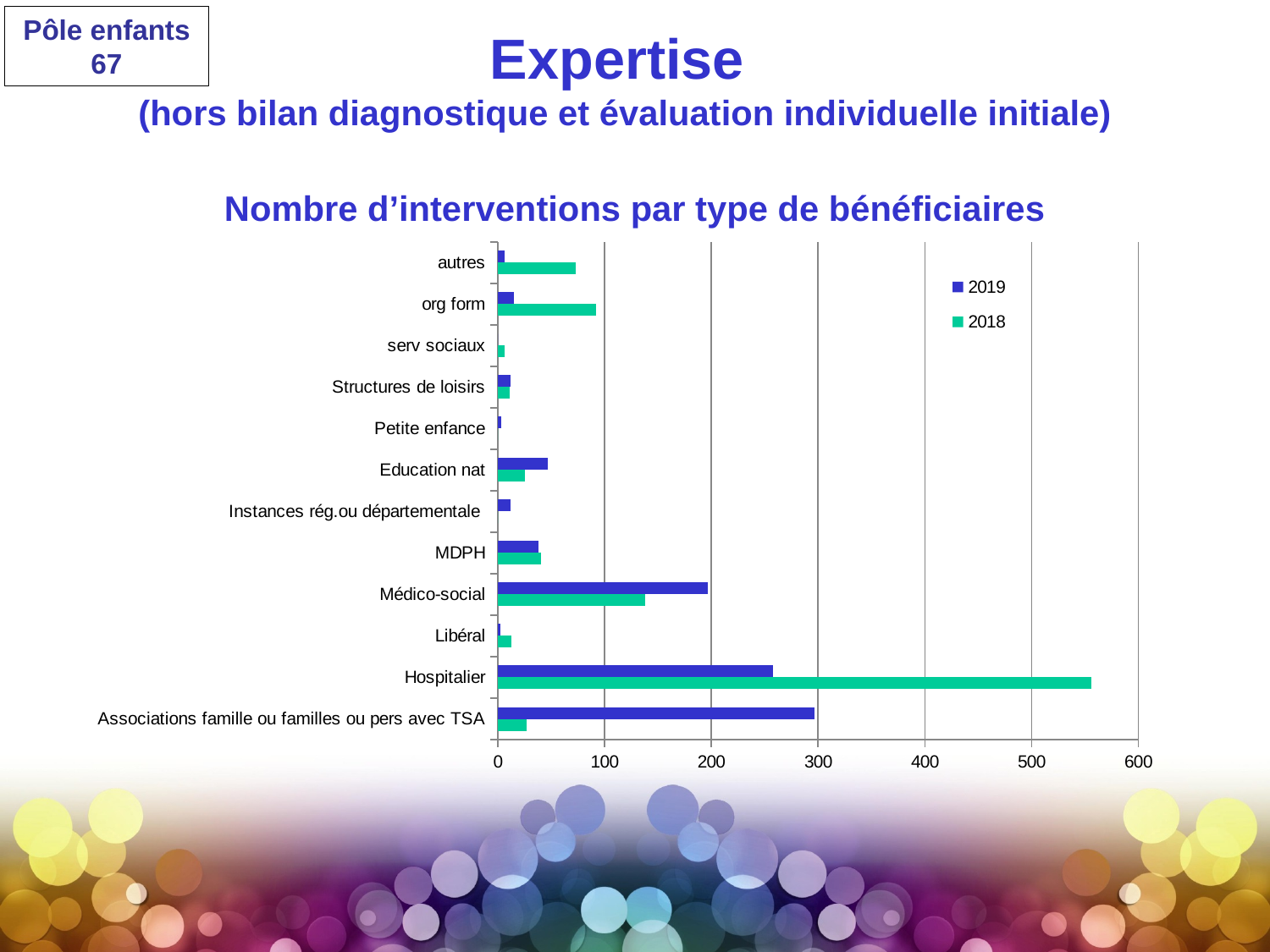
Which category has the highest value for 2018? Hospitalier Which is larger for Education nat: the 2018 value or the 2019 value? 2019 Is the value for Associations famille ou familles ou pers avec TSA in 2018 greater or less than 100? less What kind of chart is shown on the slide? bar chart Which is larger for Hospitalier: the 2018 value or the 2019 value? 2018 Is the value for Médico-social in 2019 greater or less than 100? greater What is the title of the chart? Nombre d’interventions par type de bénéficiaires Is the value for Hospitalier in 2018 greater or less than 500? greater Which category has the highest value for 2019? Associations famille ou familles ou pers avec TSA How many series does the legend list? 2 How many categories of beneficiaries are shown on the chart? 12